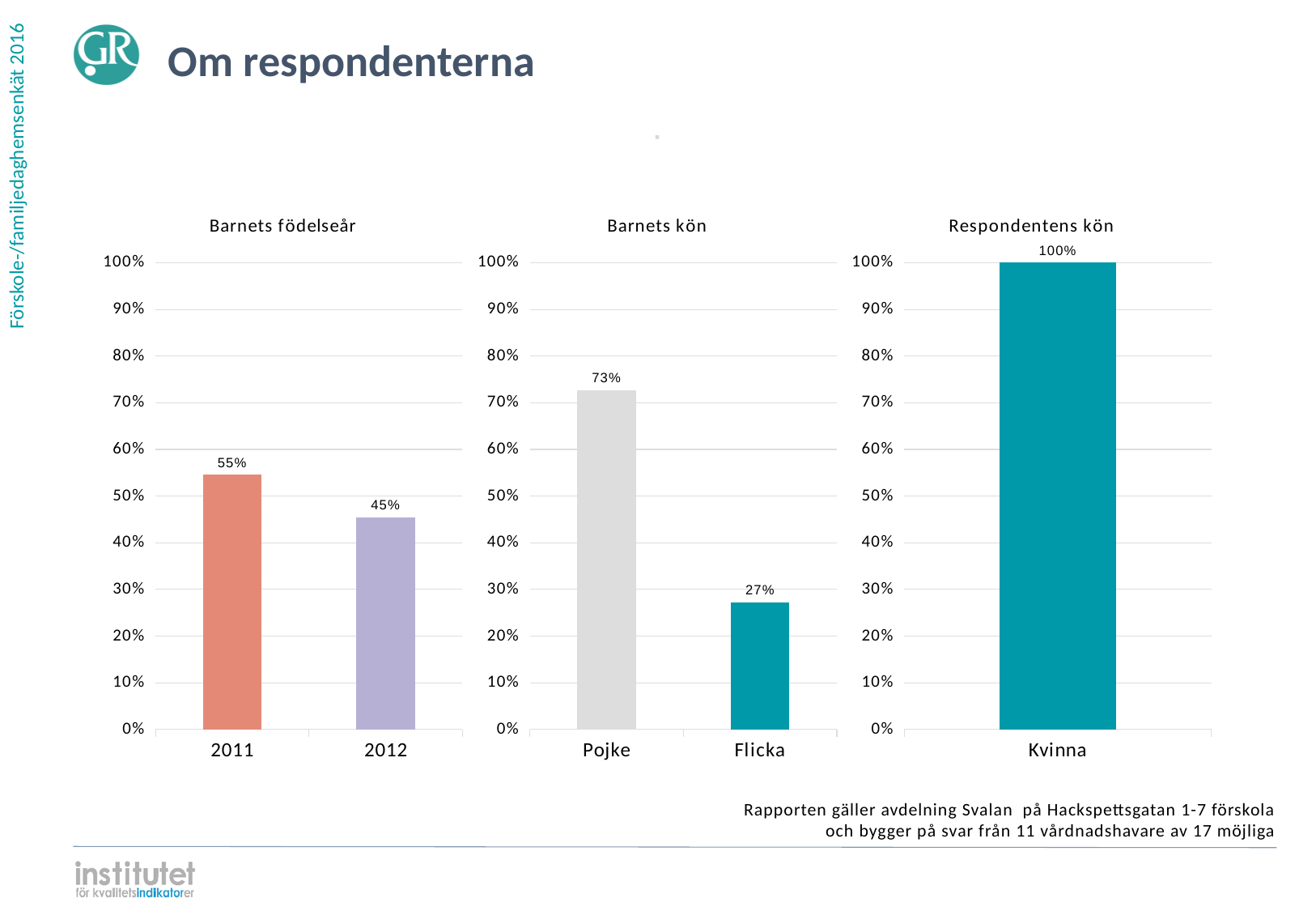
In the 'Barnets födelseår' chart, which category has the highest value? 2011 In the 'Barnets födelseår' chart, what is the difference between the values for 2011 and 2012? 10% How many categories are shown in the 'Respondentens kön' chart? 1 In the 'Respondentens kön' chart, what is the value for Kvinna? 100% In the 'Barnets kön' chart, what is the difference between the values for Pojke and Flicka? 46% What kind of chart is the 'Barnets kön' chart? Bar chart In the 'Barnets kön' chart, what is the value for Pojke? 73% In the 'Barnets kön' chart, what is the value for Flicka? 27% In the 'Barnets kön' chart, is the value for Pojke greater or less than 70%? greater In the 'Barnets födelseår' chart, what is the value for 2011? 55% In the 'Barnets födelseår' chart, what is the value for 2012? 45% In the 'Barnets kön' chart, which category has the lowest value? Flicka